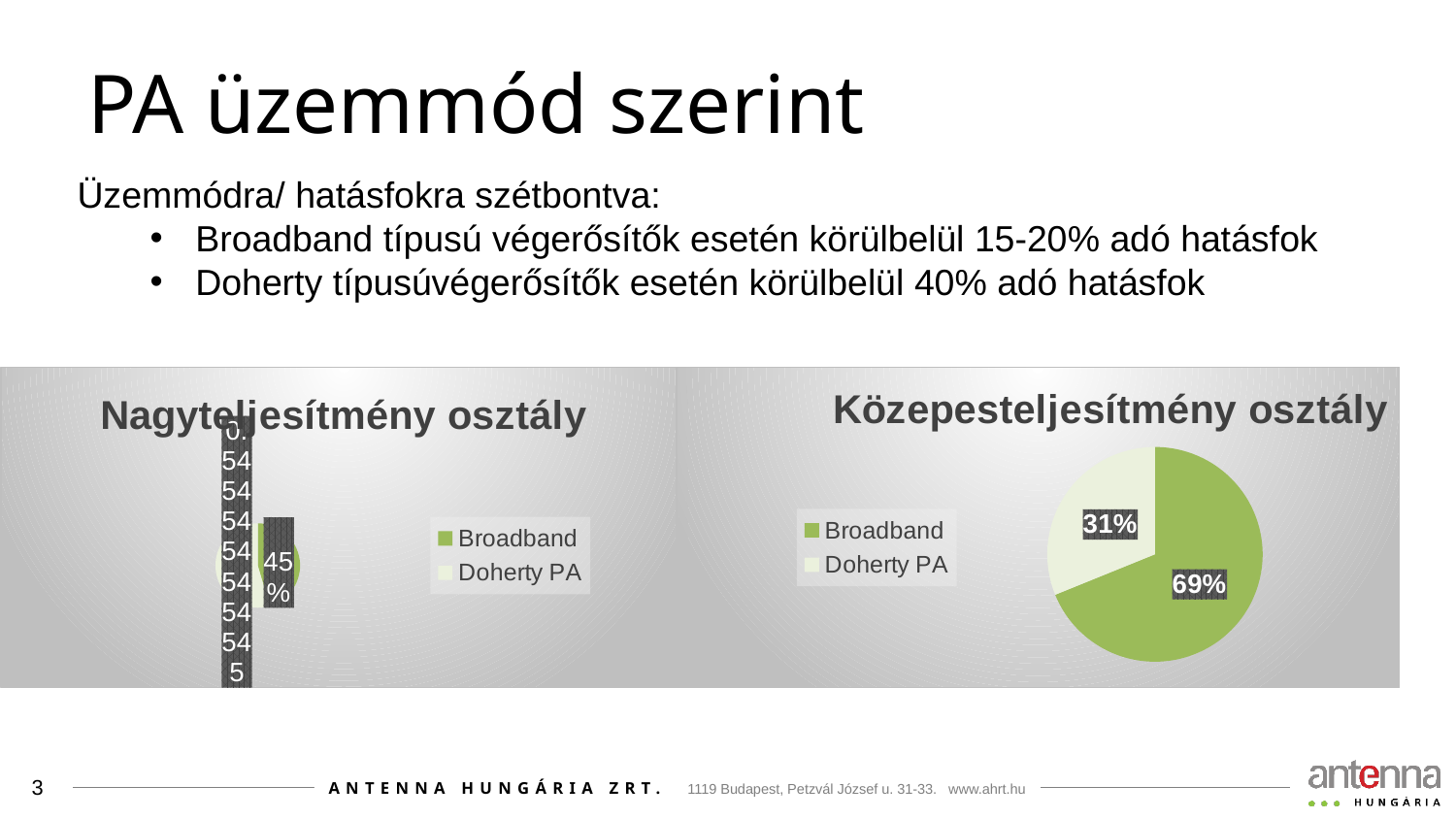
In the chart titled "Közepesteljesítmény osztály", by how many percentage points does Broadband exceed Doherty PA? 38 percentage points In the chart titled "Közepesteljesítmény osztály", which category has the smallest slice? Doherty PA What kind of chart is the one titled "Közepesteljesítmény osztály"? Pie chart In the chart titled "Közepesteljesítmény osztály", how many slices does the pie have? 2 In the chart titled "Közepesteljesítmény osztály", what share does Doherty PA have? 31% In the chart titled "Közepesteljesítmény osztály", which is larger: Broadband or Doherty PA? Broadband How many entries does the legend of the chart titled "Nagyteljesítmény osztály" list? 2 In the chart titled "Közepesteljesítmény osztály", what colour is the Broadband slice? Green In the chart titled "Közepesteljesítmény osztály", what share does Broadband have? 69% In the chart titled "Közepesteljesítmény osztály", which category has the largest slice? Broadband What are the two legend entries in the chart titled "Nagyteljesítmény osztály"? Broadband and Doherty PA In the chart titled "Közepesteljesítmény osztály", how many entries does the legend list? 2